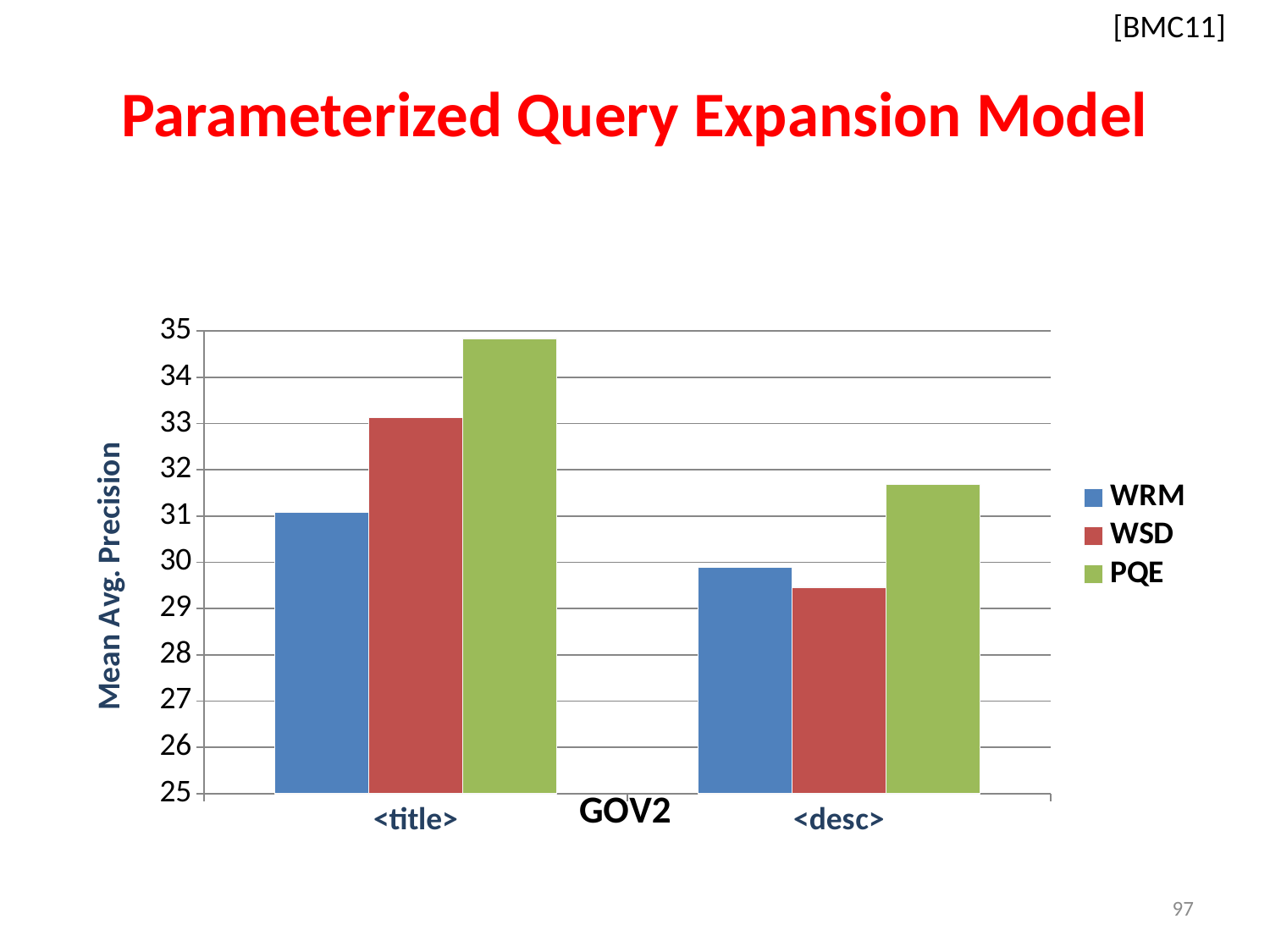
How many categories are shown on the x axis? 2 Is the PQE value for <title> greater or less than 34? greater Which series has the highest Mean Avg. Precision for <title>? PQE Is the PQE value for <desc> greater or less than 31? greater Is the WSD value for <desc> greater or less than 30? less What kind of chart is shown on the slide? bar chart For <desc>, which is larger: WRM or WSD? WRM What is the label of the y axis? Mean Avg. Precision What label appears below the x axis between the two categories? GOV2 Which series has the lowest Mean Avg. Precision for <title>? WRM How many series does the legend list? 3 Which series has the lowest Mean Avg. Precision for <desc>? WSD